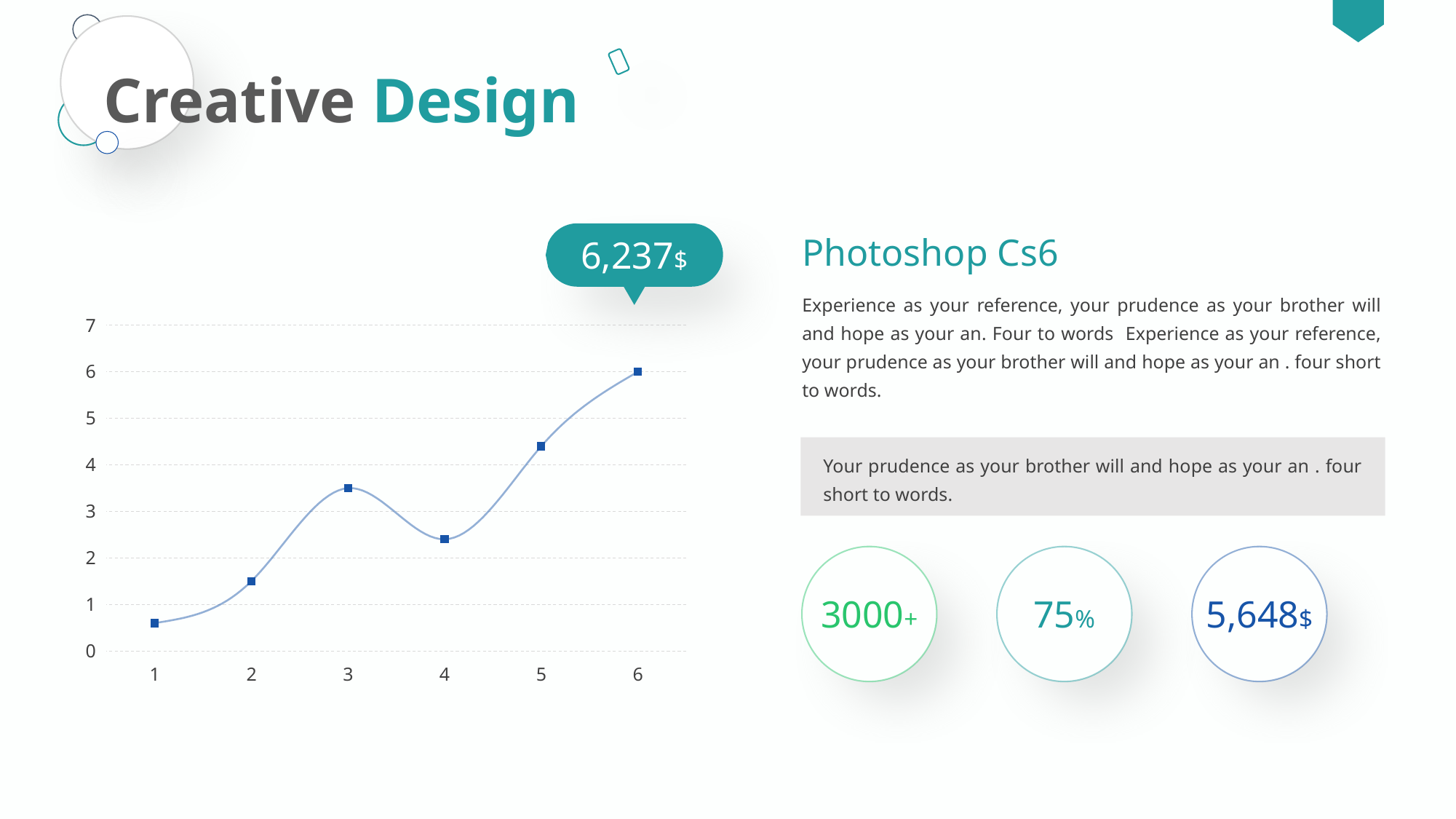
Which category on the x axis has the lowest value? 1 What kind of chart is shown on the slide? line chart What is the highest value shown on the y axis? 7 Is the value for category 3 greater or less than 3? greater Is the value for category 4 greater or less than 3? less Is the value for category 1 greater or less than 1? less Which is larger, the value at category 3 or the value at category 4? category 3 Which category on the x axis has the highest value? 6 What is the value at category 6? 6 Do the values rise or fall from category 4 to category 6? rise How many data points are plotted on the line chart? 6